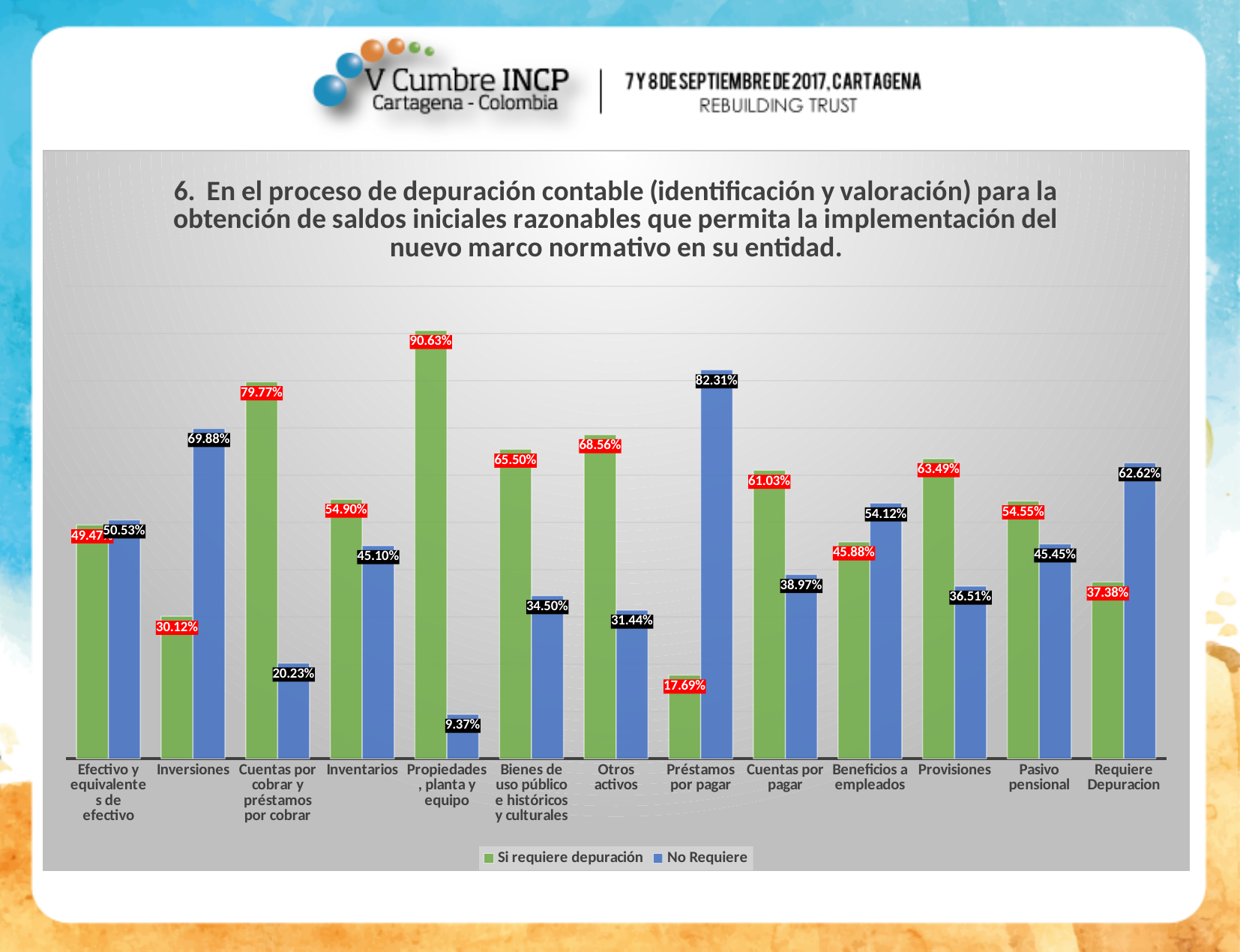
What type of chart is shown on the slide? Bar chart What is the value of "No Requiere" for Préstamos por pagar? 82.31% Which category has the lowest "No Requiere" value? Propiedades, planta y equipo What is the value of "No Requiere" for Cuentas por cobrar y préstamos por cobrar? 20.23% What is the difference between the "Si requiere depuración" and "No Requiere" values for Inventarios? 9.80% Which category has the lowest "Si requiere depuración" value? Préstamos por pagar Which category has the highest "Si requiere depuración" value? Propiedades, planta y equipo How many series does the legend list? 2 For Beneficios a empleados, which is larger: "Si requiere depuración" or "No Requiere"? No Requiere What is the value of "Si requiere depuración" for Inversiones? 30.12% What is the value of "Si requiere depuración" for Propiedades, planta y equipo? 90.63% How many categories are shown on the x axis? 13